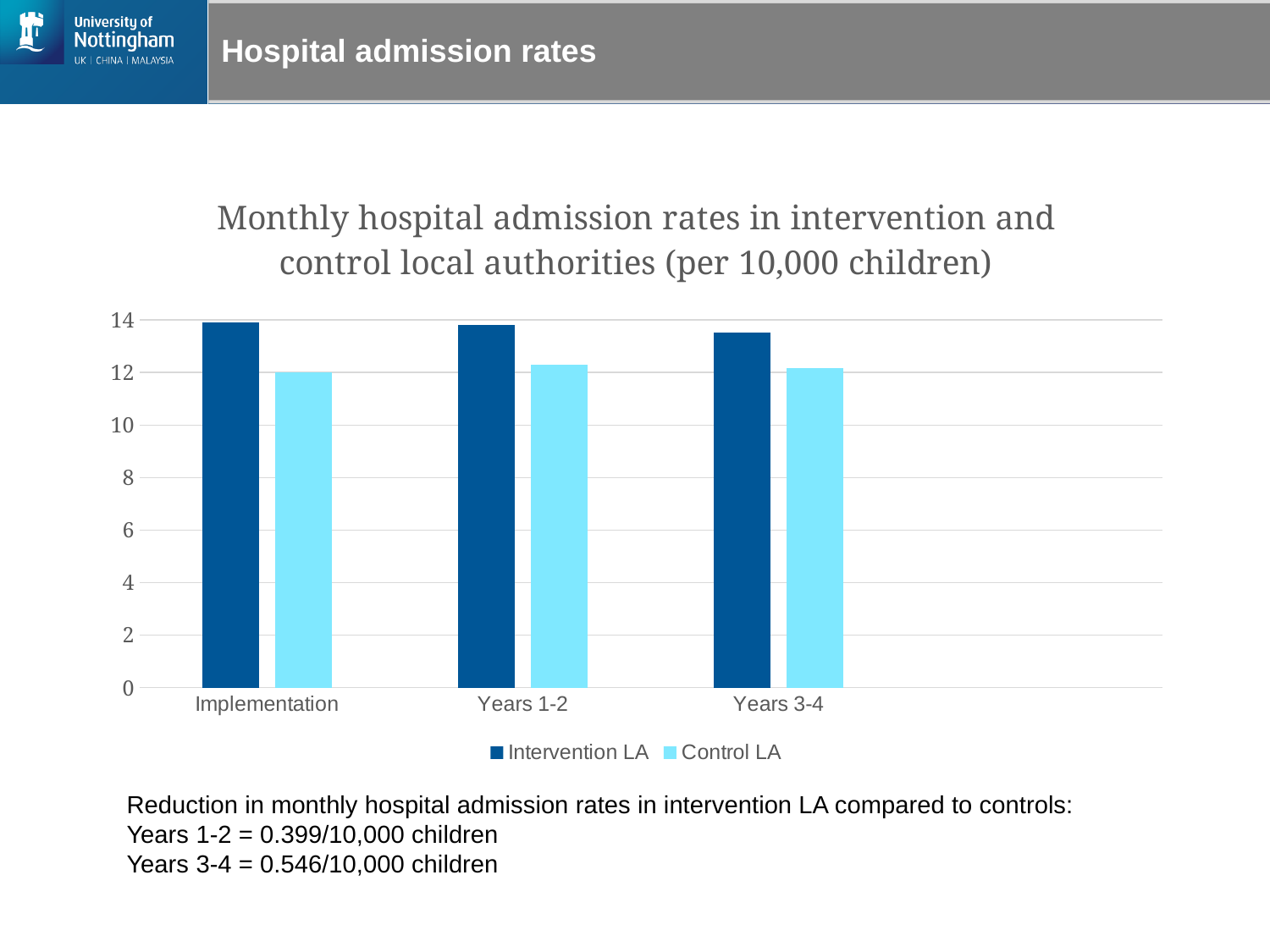
Do the Intervention LA values rise or fall from Implementation to Years 3-4? fall What kind of chart is shown on the slide? bar chart Is the value for Control LA at Implementation greater or less than 10? greater How many categories are shown on the x axis of the chart? 3 How many series does the chart's legend list? 2 Is the value for Intervention LA at Years 3-4 greater or less than 12? greater Which series is shown in dark blue in the chart? Intervention LA What is the title of the chart? Monthly hospital admission rates in intervention and control local authorities (per 10,000 children) Is the value for Control LA at Years 3-4 greater or less than 14? less At Years 3-4, which is larger: Intervention LA or Control LA? Intervention LA At Years 1-2, which is larger: Intervention LA or Control LA? Intervention LA